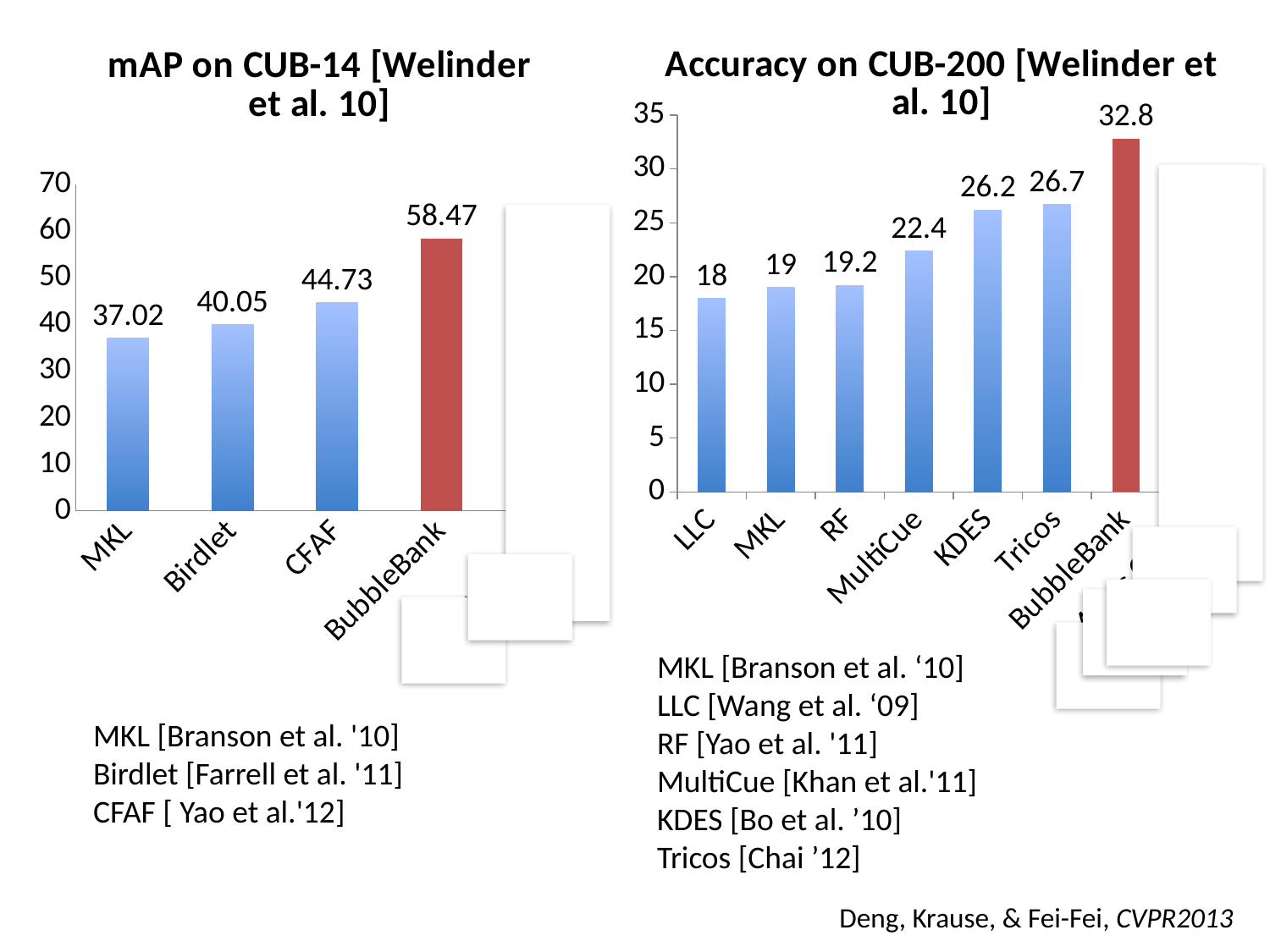
In the 'Accuracy on CUB-200' chart, which method has the lowest value? LLC In the 'Accuracy on CUB-200' chart, which method has the highest value? BubbleBank In the 'Accuracy on CUB-200' chart, what is the value for MultiCue? 22.4 In the 'mAP on CUB-14' chart, what is the difference between BubbleBank and CFAF? 13.74 In the 'Accuracy on CUB-200' chart, what is the value for KDES? 26.2 In the 'Accuracy on CUB-200' chart, how many methods are shown? 7 In the 'mAP on CUB-14' chart, what is the value for Birdlet? 40.05 In the 'mAP on CUB-14' chart, what is the value for BubbleBank? 58.47 In the 'Accuracy on CUB-200' chart, what is the difference between BubbleBank and Tricos? 6.1 In the 'mAP on CUB-14' chart, how many methods are shown? 4 In the 'mAP on CUB-14' chart, which method has the lowest value? MKL What type of chart is the 'Accuracy on CUB-200' chart? Bar chart